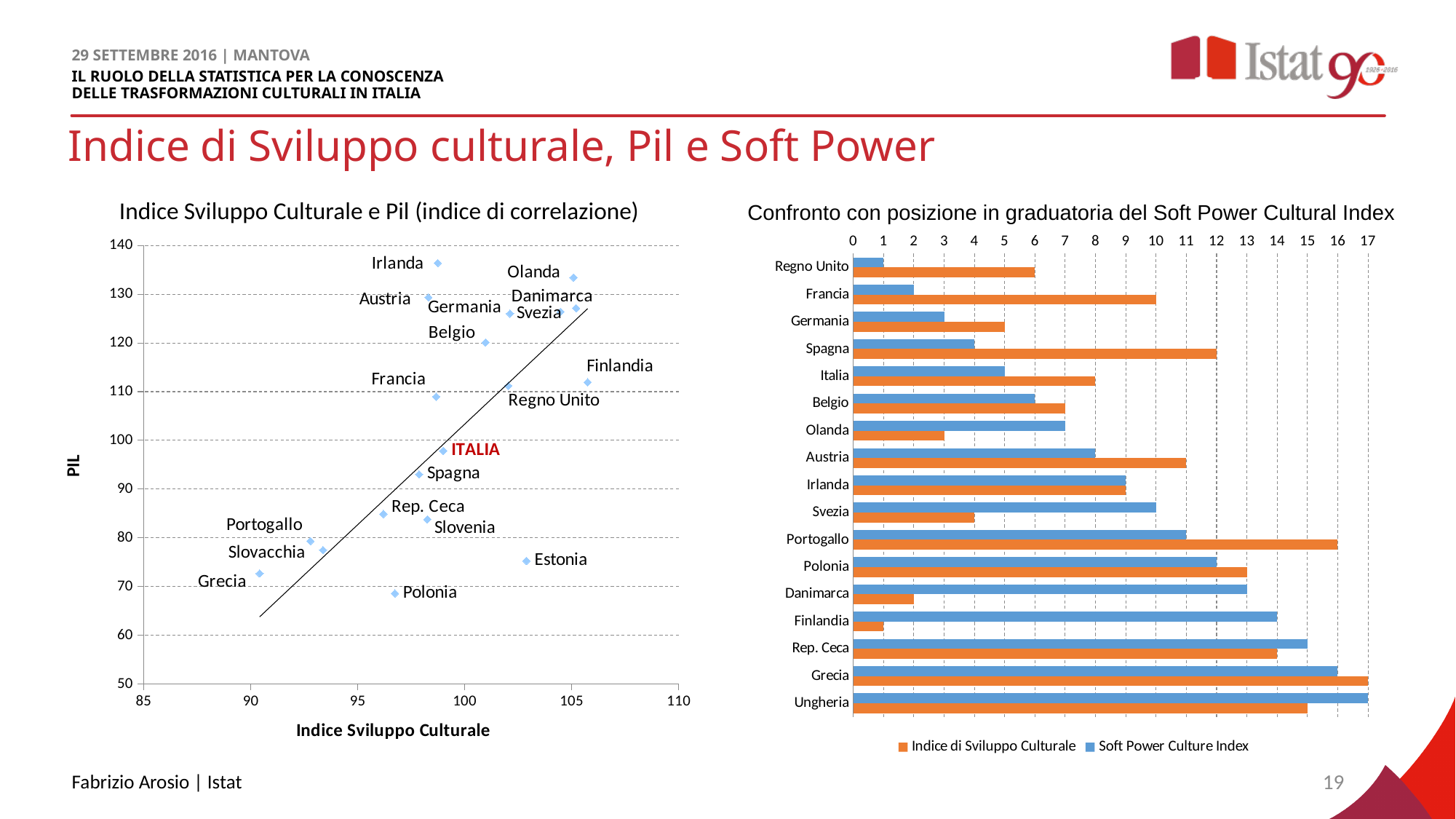
What kind of chart is 'Confronto con posizione in graduatoria del Soft Power Cultural Index'? Bar chart How many countries are shown in the chart 'Confronto con posizione in graduatoria del Soft Power Cultural Index'? 17 In the chart 'Confronto con posizione in graduatoria del Soft Power Cultural Index', what is the difference between the Indice di Sviluppo Culturale and the Soft Power Culture Index values for Spagna? 8 In the chart 'Indice Sviluppo Culturale e Pil (indice di correlazione)', is the PIL value for Estonia greater or less than 80? less In the chart 'Confronto con posizione in graduatoria del Soft Power Cultural Index', which is larger for Danimarca: the Indice di Sviluppo Culturale or the Soft Power Culture Index? Soft Power Culture Index In the chart 'Confronto con posizione in graduatoria del Soft Power Cultural Index', which country has the lowest Indice di Sviluppo Culturale value? Finlandia In the chart 'Confronto con posizione in graduatoria del Soft Power Cultural Index', what is the Soft Power Culture Index rank for Italia? 5 What kind of chart is 'Indice Sviluppo Culturale e Pil (indice di correlazione)'? Scatter plot In the chart 'Confronto con posizione in graduatoria del Soft Power Cultural Index', which country has the highest Indice di Sviluppo Culturale value? Grecia In the chart 'Indice Sviluppo Culturale e Pil (indice di correlazione)', is the PIL value for Irlanda greater or less than 130? greater In the chart 'Confronto con posizione in graduatoria del Soft Power Cultural Index', what is the Indice di Sviluppo Culturale rank for Portogallo? 16 How many series does the legend of the chart 'Confronto con posizione in graduatoria del Soft Power Cultural Index' list? 2